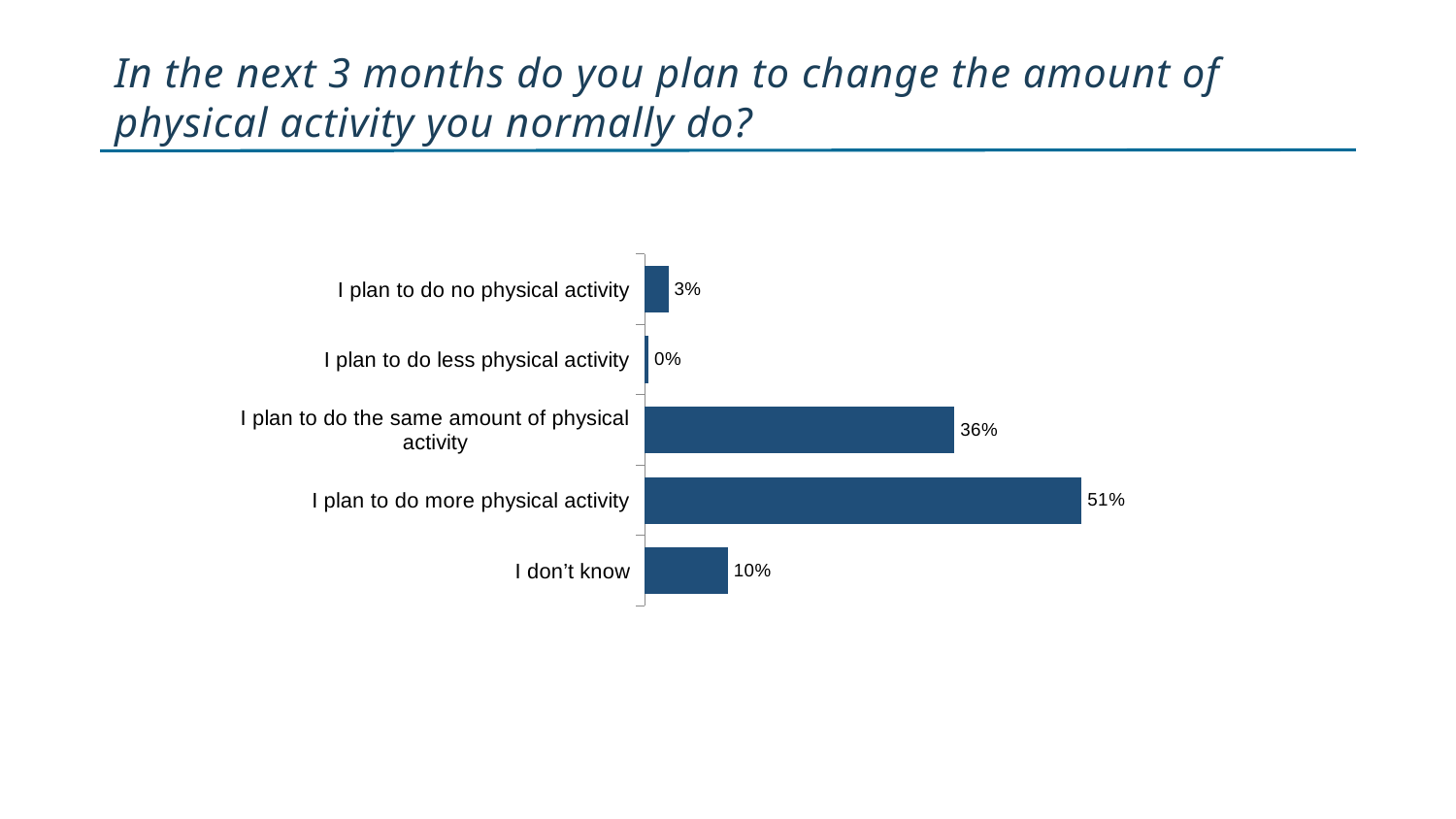
Which response has the lowest percentage? I plan to do less physical activity How many response categories are shown in the chart? 5 What percentage of respondents answered 'I don't know'? 10% Which is larger: the percentage for 'I don't know' or for 'I plan to do no physical activity'? I don't know What percentage of respondents plan to do no physical activity? 3% What type of chart is shown on the slide? Bar chart What is the difference in percentage points between 'I plan to do more physical activity' and 'I plan to do the same amount of physical activity'? 15 What percentage of respondents plan to do less physical activity? 0% What percentage of respondents plan to do more physical activity? 51% Which response has the highest percentage? I plan to do more physical activity What question does the chart on the slide address? In the next 3 months do you plan to change the amount of physical activity you normally do? What percentage of respondents plan to do the same amount of physical activity? 36%